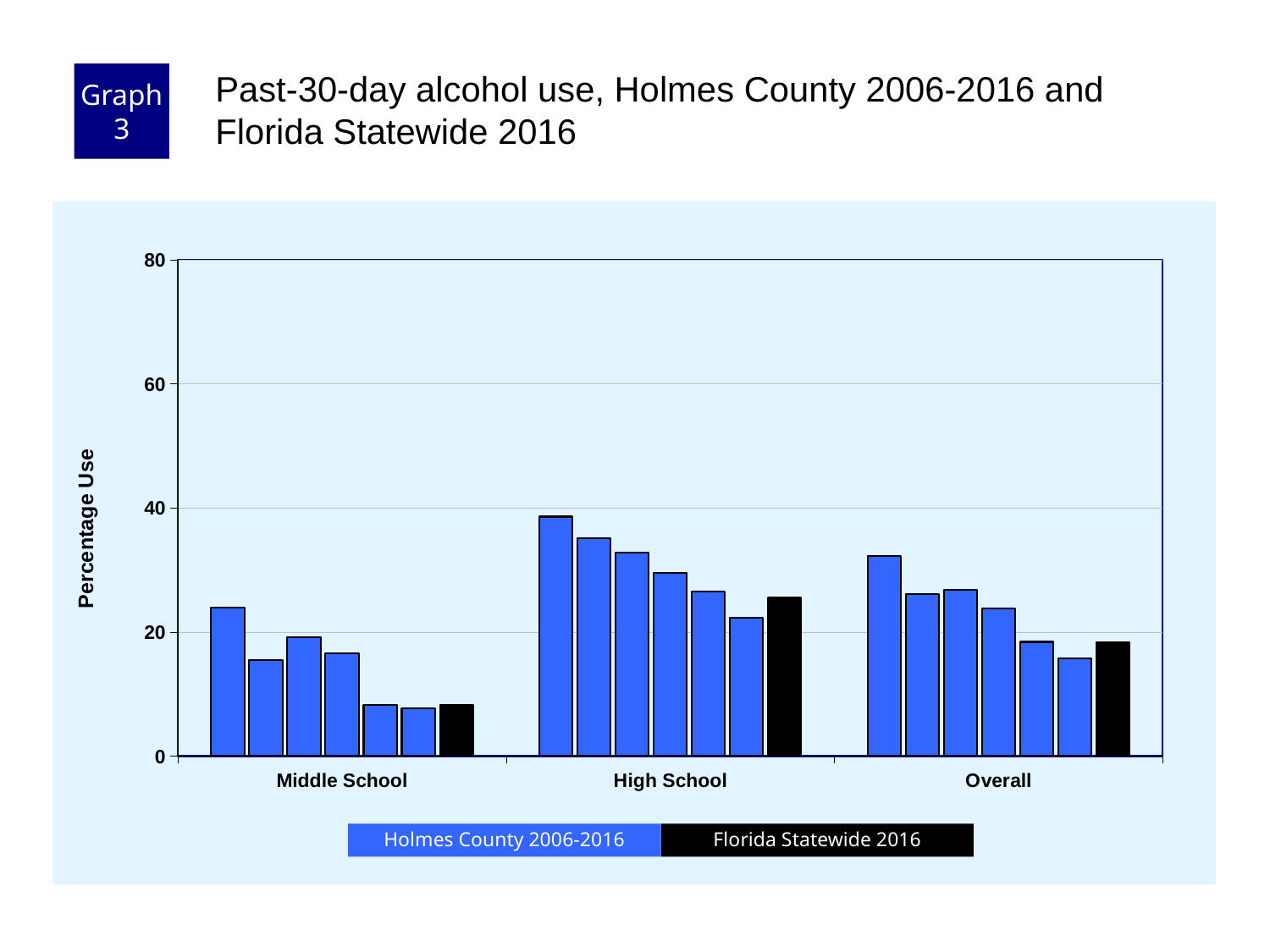
What is the label on the y axis? Percentage Use Within the High School group, do the Holmes County 2006-2016 bars rise or fall from left to right? fall Which is larger, the Florida Statewide 2016 value for High School or for Middle School? High School Which category has the highest bars overall: Middle School, High School, or Overall? High School Is the Florida Statewide 2016 value for Middle School greater or less than 20? less Is the tallest Holmes County bar in the Overall group greater or less than 20? greater What kind of chart is shown on the slide? bar chart Is the tallest Holmes County bar in the High School group greater or less than 40? less How many categories are shown on the x axis? 3 How many series does the legend list? 2 What colour represents Florida Statewide 2016 in the legend? black